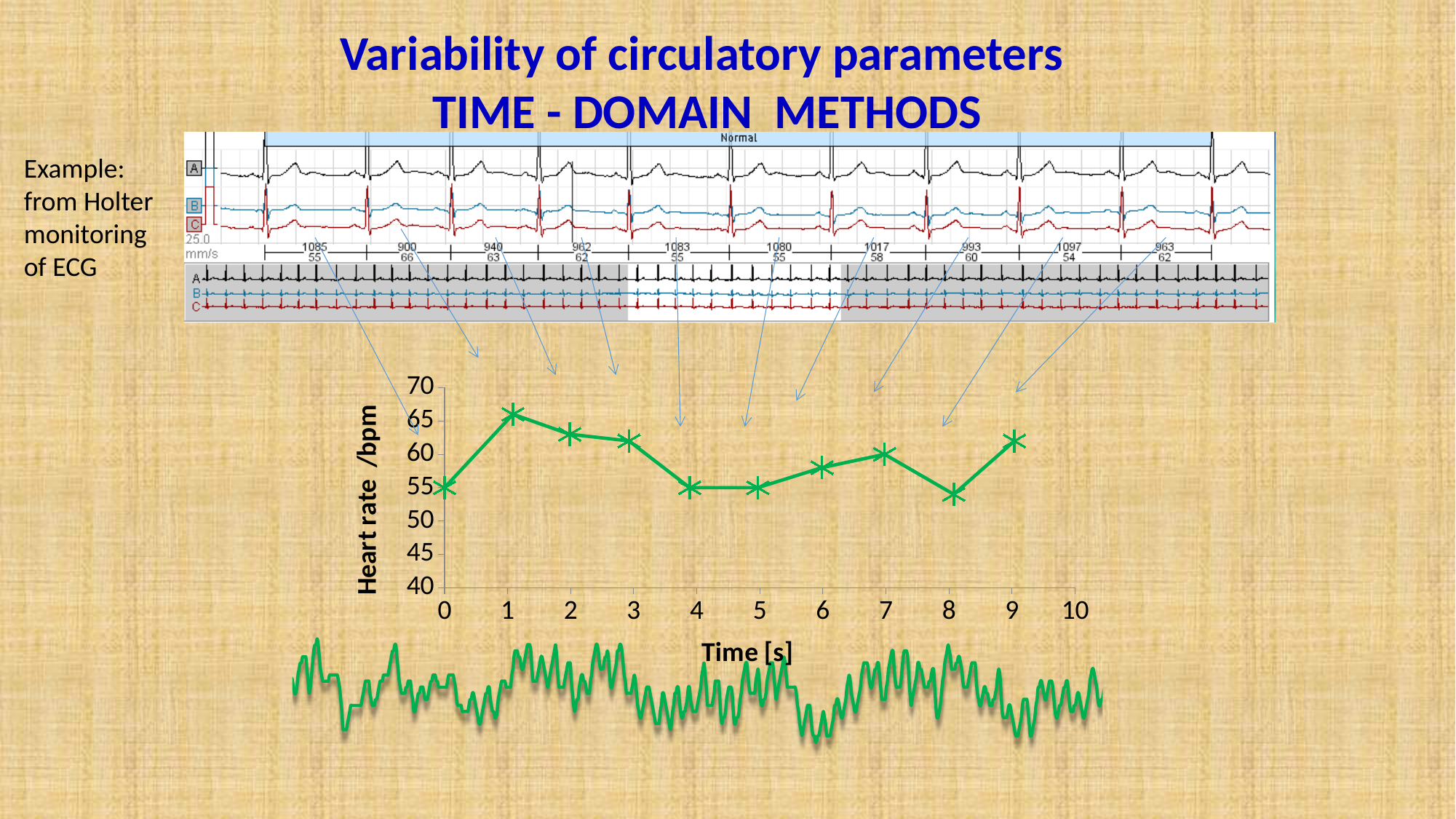
How many data points are plotted on the heart rate chart? 10 What is the heart rate at time 7 s? 60 At which time is the heart rate lowest? 8 s At which time is the heart rate highest? 1 s Is the heart rate at 8 s greater or less than 55? less Is the heart rate at 1 s greater or less than 65? greater What is the label of the vertical axis of the heart rate chart? Heart rate /bpm Which is larger, the heart rate at 1 s or at 4 s? 1 s Does the heart rate rise or fall between 1 s and 4 s? fall Is the heart rate at 2 s greater or less than 60? greater What kind of chart is the heart rate chart on the slide? line chart What is the heart rate at time 0 s? 55